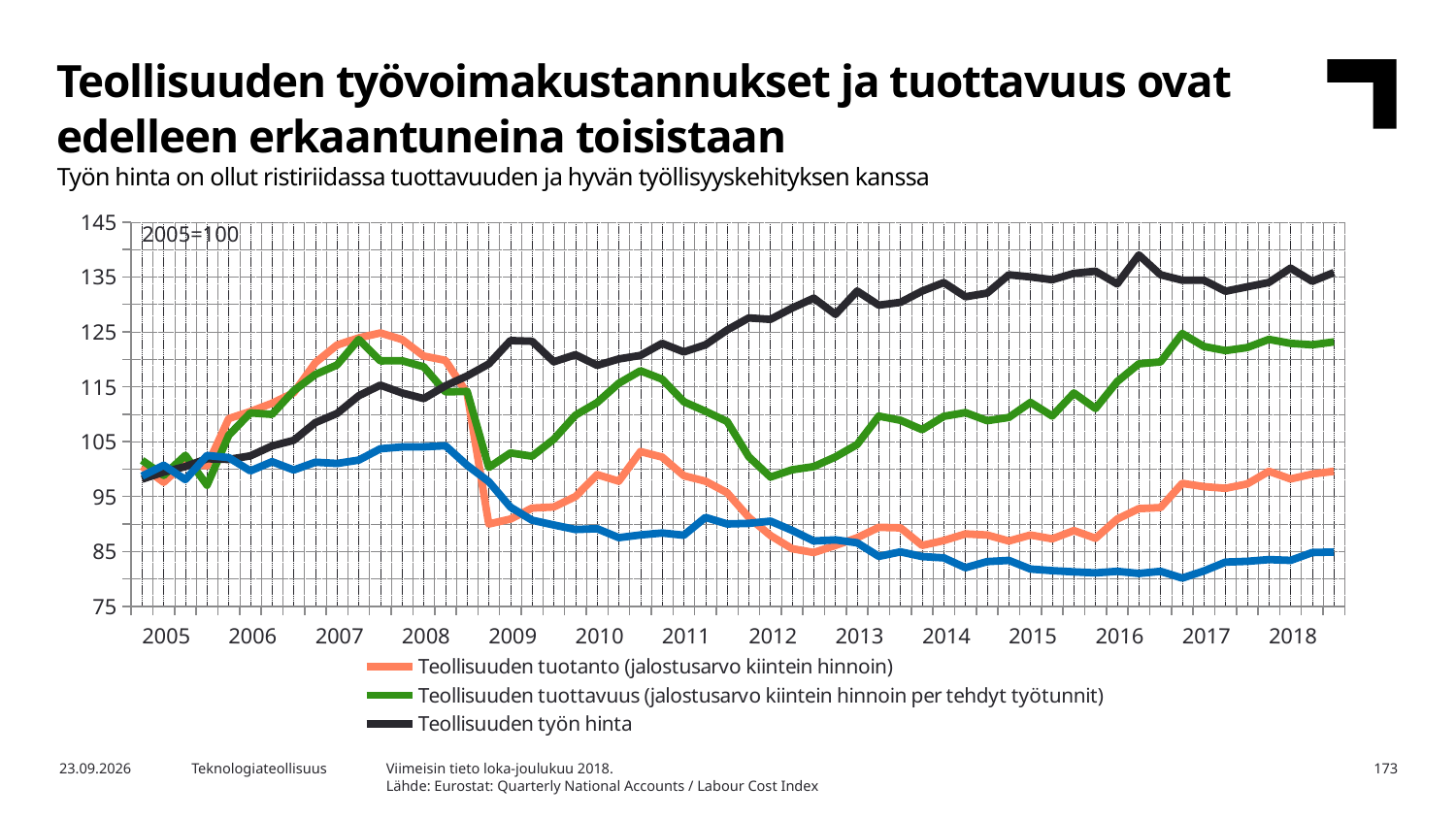
Does the Teollisuuden tuotanto line rise or fall from its 2008 peak to 2009? fall Which of the legend series is lowest at the end of 2018? Teollisuuden tuotanto (jalostusarvo kiintein hinnoin) Is the value for Teollisuuden tuottavuus at the end of 2018 greater or less than 115? greater Is the value for Teollisuuden tuotanto at the end of 2018 greater or less than 105? less What base year and index value is noted in the top-left corner of the chart? 2005=100 Is the value for Teollisuuden tuotanto at the start of 2009 greater or less than 95? less At the end of 2018, which is larger: Teollisuuden työn hinta or Teollisuuden tuottavuus? Teollisuuden työn hinta What kind of chart is shown on the slide? line chart How many series does the legend list? 3 Does the Teollisuuden työn hinta line rise or fall overall from 2005 to 2018? rise Which series is highest at the end of 2018? Teollisuuden työn hinta